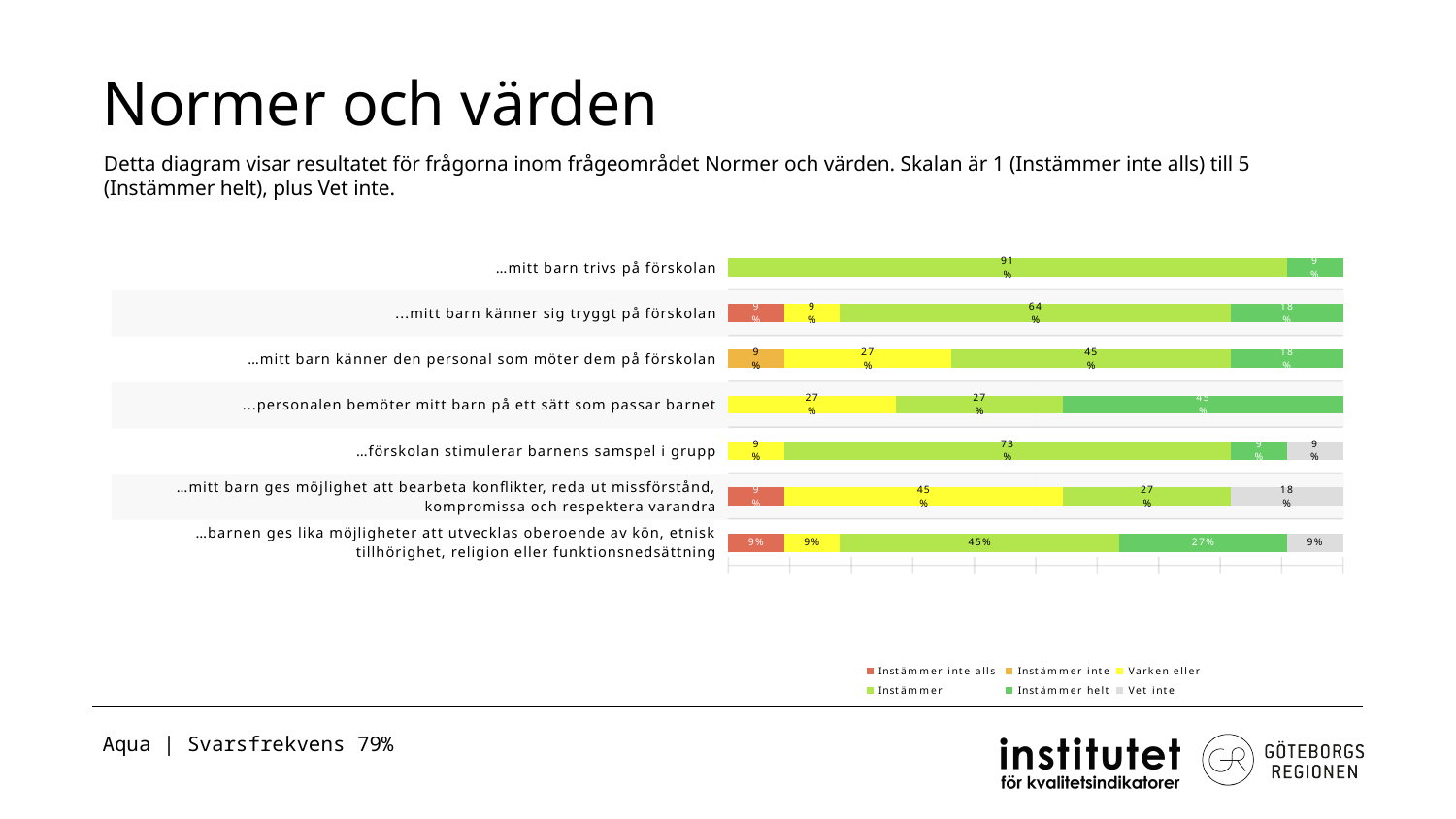
Which category has the highest Instämmer value? …mitt barn trivs på förskolan How many question categories are plotted in the chart? 7 What is the Vet inte value for "…barnen ges lika möjligheter att utvecklas oberoende av kön, etnisk tillhörighet, religion eller funktionsnedsättning"? 9% What is the Instämmer helt value for "…personalen bemöter mitt barn på ett sätt som passar barnet"? 45% What kind of chart is shown on the slide? Stacked bar chart What is the title of the slide containing the chart? Normer och värden What is the Instämmer value for "…mitt barn känner sig tryggt på förskolan"? 64% What is the Varken eller value for "…mitt barn ges möjlighet att bearbeta konflikter, reda ut missförstånd, kompromissa och respektera varandra"? 45% What is the Instämmer value for "…mitt barn trivs på förskolan"? 91% What is the difference between the Instämmer values for "…mitt barn trivs på förskolan" and "…förskolan stimulerar barnens samspel i grupp"? 18% Which is larger: the Instämmer helt value for "…personalen bemöter mitt barn på ett sätt som passar barnet" or for "…mitt barn känner sig tryggt på förskolan"? …personalen bemöter mitt barn på ett sätt som passar barnet How many series does the legend list? 6